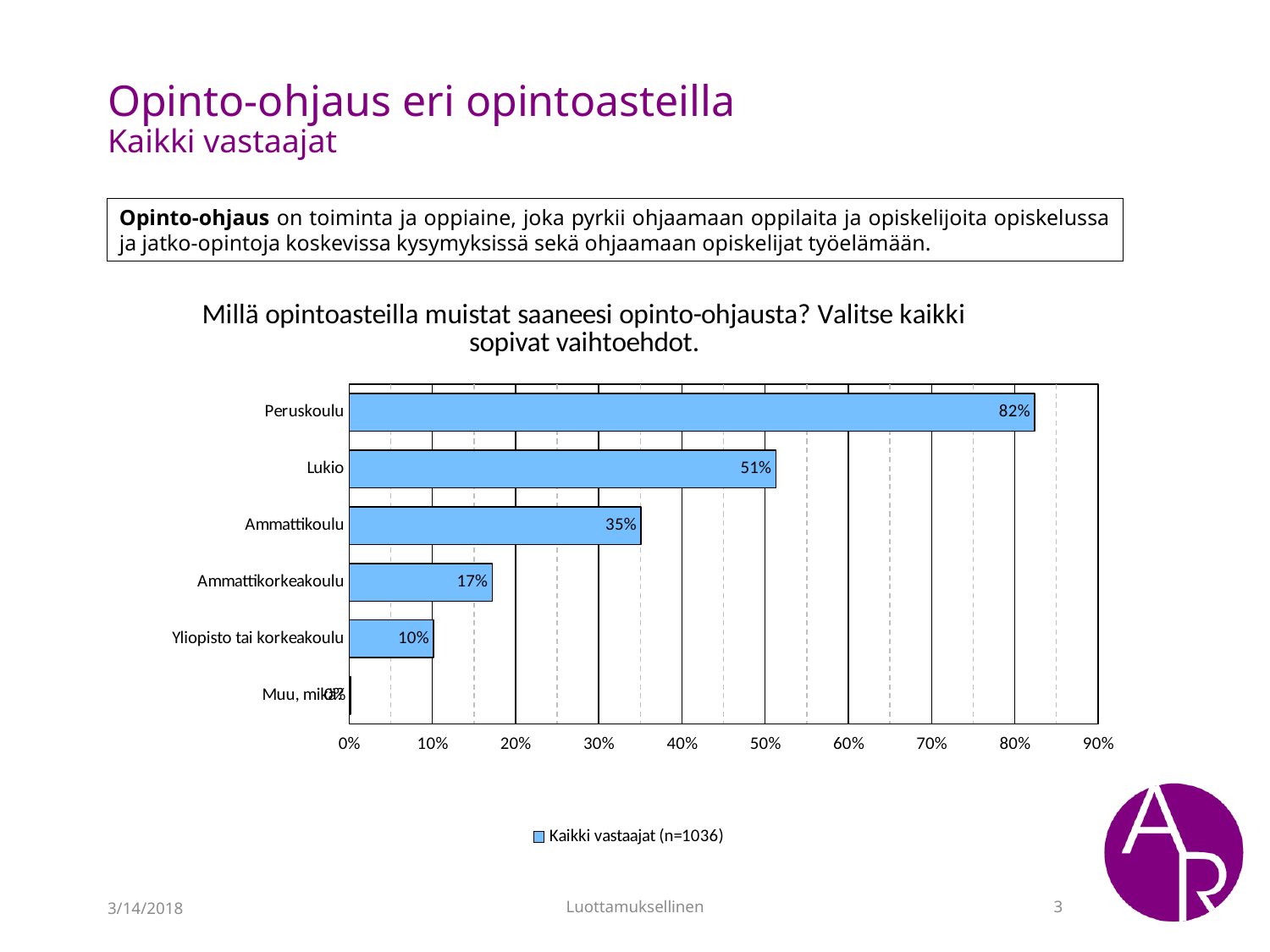
What is the difference between the values for Ammattikoulu and Ammattikorkeakoulu? 18 percentage points What series does the legend list? Kaikki vastaajat (n=1036) What kind of chart is shown on the slide? Bar chart What is the value shown for Lukio? 51% What is the value shown for Ammattikoulu? 35% How many categories are shown on the chart? 6 Which is larger, the value for Lukio or the value for Ammattikoulu? Lukio What is the value shown for Yliopisto tai korkeakoulu? 10% What is the difference between the values for Peruskoulu and Lukio? 31 percentage points Which category has the highest value in the chart? Peruskoulu What percentage of respondents remember receiving study guidance at Peruskoulu? 82% What is the value shown for Ammattikorkeakoulu? 17%